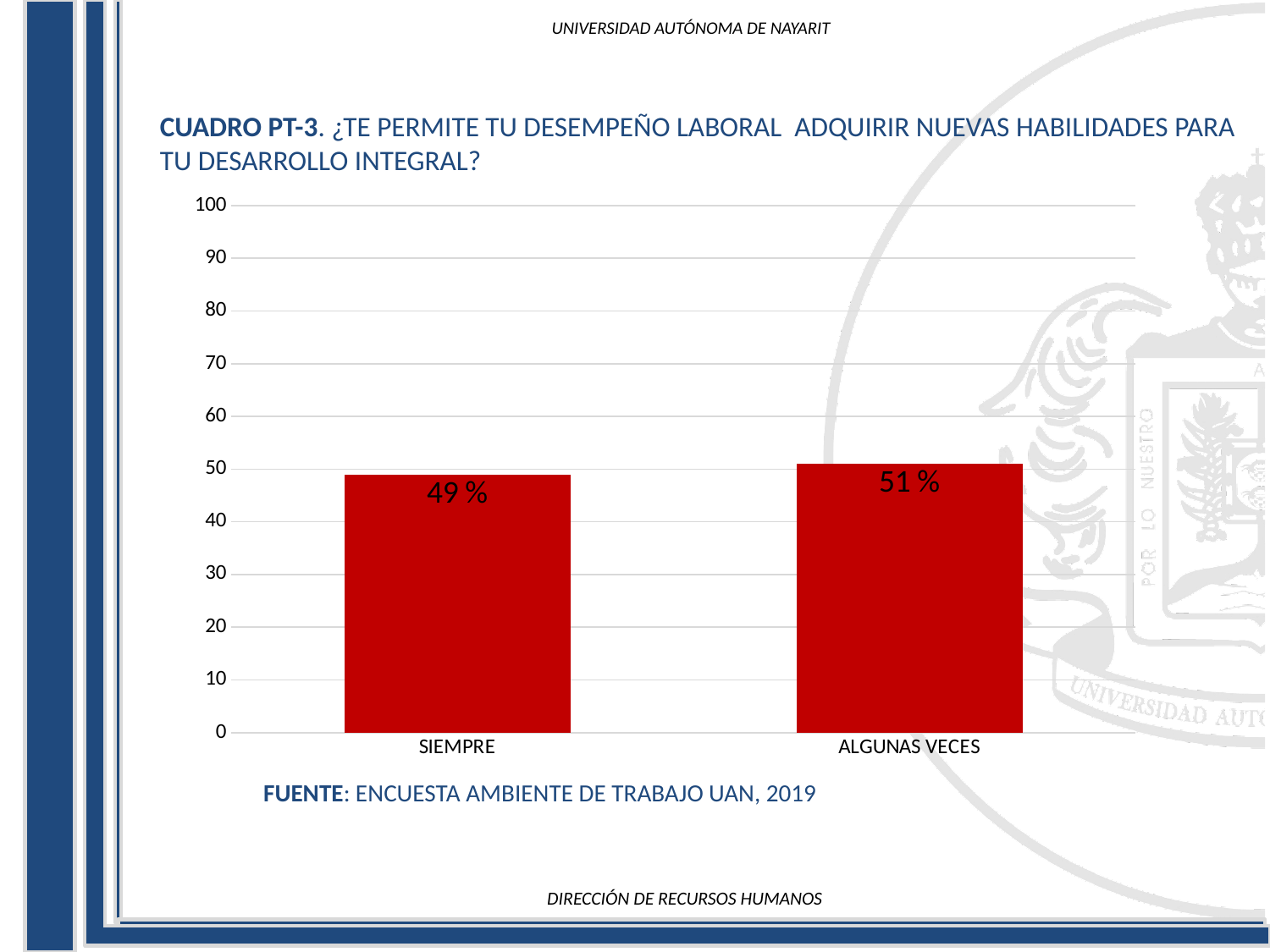
Which category has the highest value? ALGUNAS VECES What is the value for SIEMPRE? 49 % What colour are the bars in the chart? red What is the difference between the values for ALGUNAS VECES and SIEMPRE? 2 % Is the value for ALGUNAS VECES greater or less than 50? greater What is the value for ALGUNAS VECES? 51 % Which category has the lowest value? SIEMPRE Is the value for SIEMPRE greater or less than 50? less Which is larger, the value for SIEMPRE or the value for ALGUNAS VECES? ALGUNAS VECES What kind of chart is shown on the slide? bar chart What is the maximum value shown on the vertical axis? 100 How many categories are shown on the x axis? 2